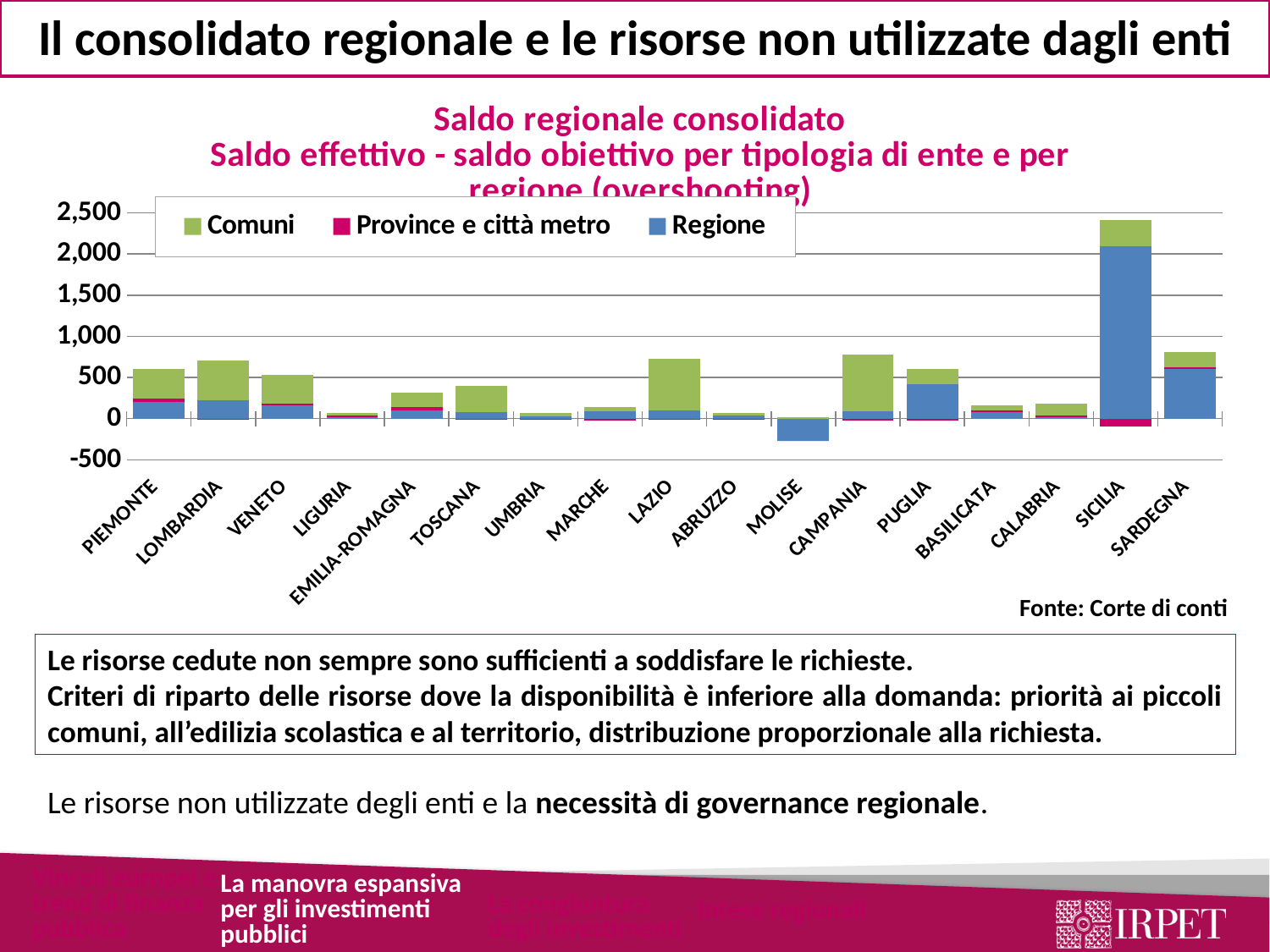
Is the total value for CAMPANIA greater or less than 500? greater Is the total value for LIGURIA greater or less than 500? less What kind of chart is shown on the slide? Stacked bar chart Which has the larger total bar, LOMBARDIA or LIGURIA? LOMBARDIA Is the total value for LOMBARDIA greater or less than 500? greater Which region has the highest total bar in the chart? SICILIA How many regions are shown on the x axis of the chart? 17 Which has the larger total bar, SICILIA or SARDEGNA? SICILIA What source is cited below the chart? Corte di conti How many series does the chart legend list? 3